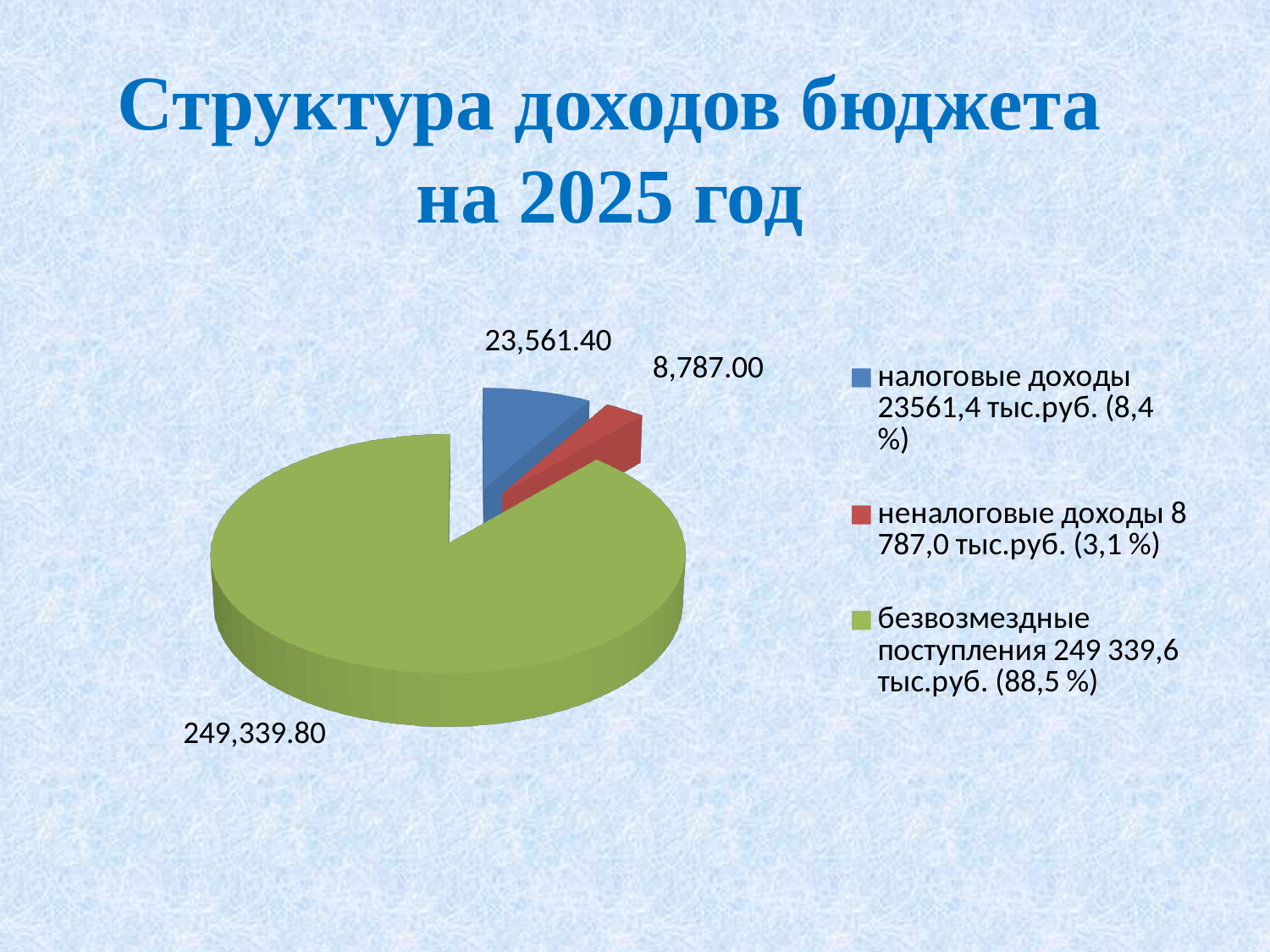
Which is larger, налоговые доходы or неналоговые доходы? налоговые доходы What value is shown for налоговые доходы? 23,561.40 How many slices does the pie chart have? 3 Which colour represents неналоговые доходы in the pie chart? red What value is shown for неналоговые доходы? 8,787.00 According to the legend, what share of the pie do безвозмездные поступления make up? 88,5 % Which category has the largest slice of the pie? безвозмездные поступления What is the difference between the values for налоговые доходы and неналоговые доходы? 14,774.40 What value is shown for безвозмездные поступления? 249,339.80 What is the title of the chart on the slide? Структура доходов бюджета на 2025 год Which category has the smallest slice of the pie? неналоговые доходы What type of chart is shown on the slide? pie chart